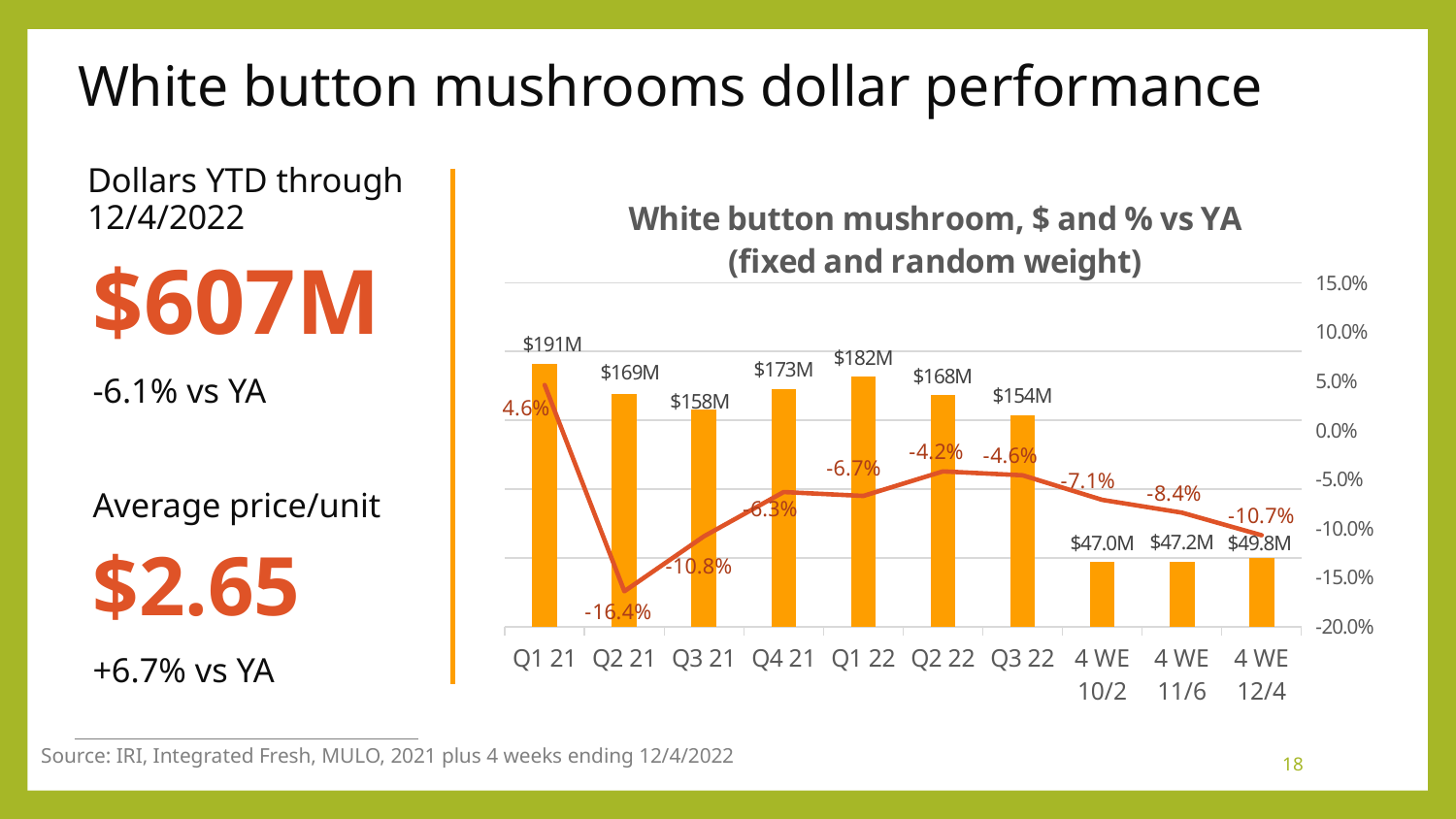
What is the % vs YA value shown for Q3 22? -4.6% What is the dollar value shown for the 4 WE 12/4 period? $49.8M Which period has the highest dollar value bar? Q1 21 Which period has the lowest % vs YA value on the line? Q2 21 Does the % vs YA line rise or fall from 4 WE 10/2 to 4 WE 12/4? Fall What is the dollar value shown for Q1 21? $191M How many periods are shown on the x axis? 10 What kind of chart is this? Combination bar and line chart What is the title of the chart? White button mushroom, $ and % vs YA (fixed and random weight) What is the difference in dollar value between Q1 21 and Q2 21? $22M Which has the larger dollar value, Q4 21 or Q1 22? Q1 22 What is the % vs YA value shown for Q2 21? -16.4%